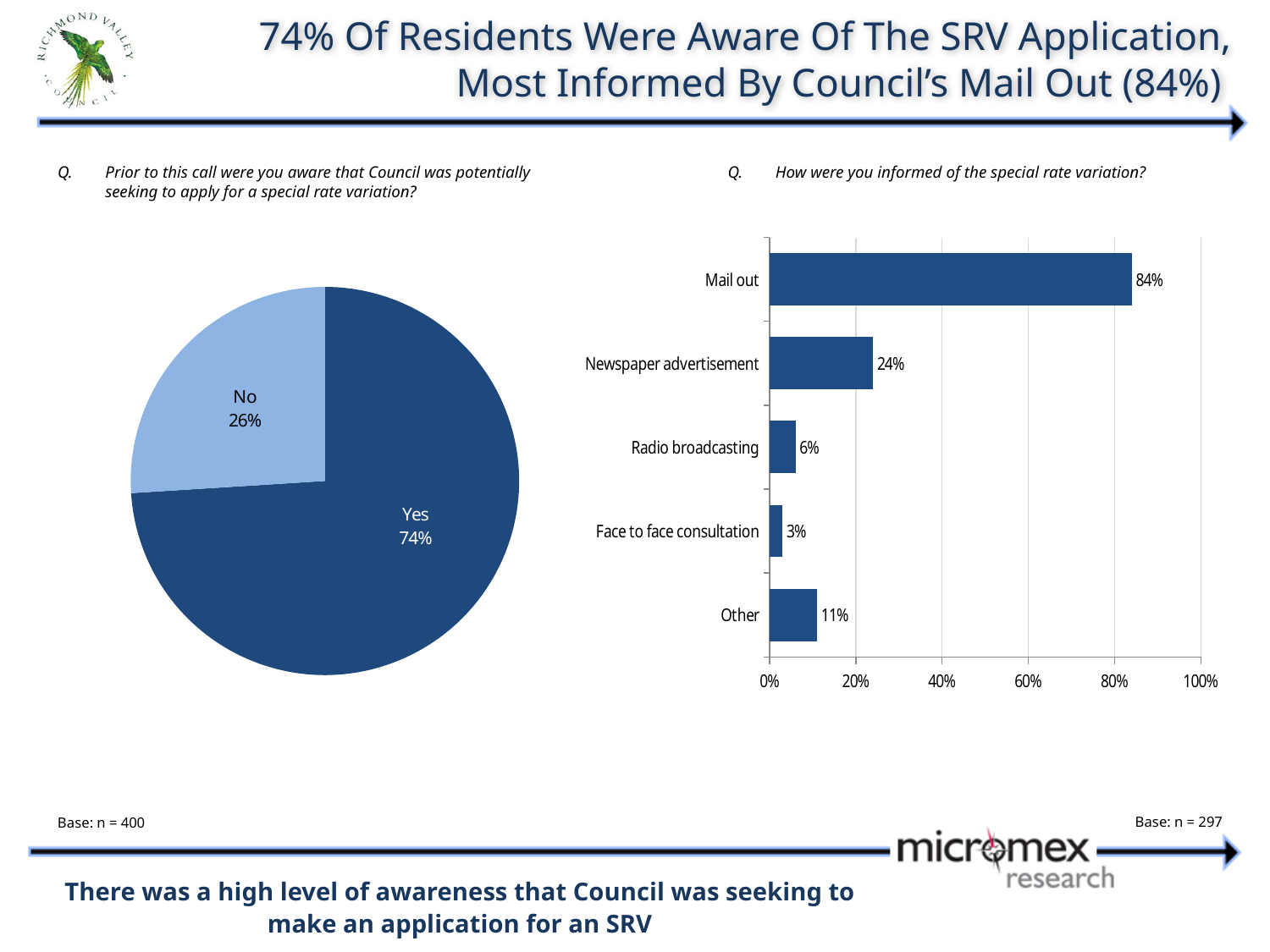
In the bar chart on the right, which is larger, Radio broadcasting or Other? Other In the bar chart on the right, what is the value for Mail out? 84% In the pie chart on the left, what share of residents answered No? 26% In the bar chart on the right, what is the difference between Mail out and Newspaper advertisement? 60% What kind of chart is the chart on the right? Bar chart In the bar chart on the right, which category has the highest value? Mail out In the bar chart on the right, what is the value for Face to face consultation? 3% In the pie chart on the left, how many slices are there? 2 In the bar chart on the right, which category has the lowest value? Face to face consultation What kind of chart is the chart on the left? Pie chart In the bar chart on the right, what is the value for Newspaper advertisement? 24% In the pie chart on the left, what share of residents answered Yes? 74%